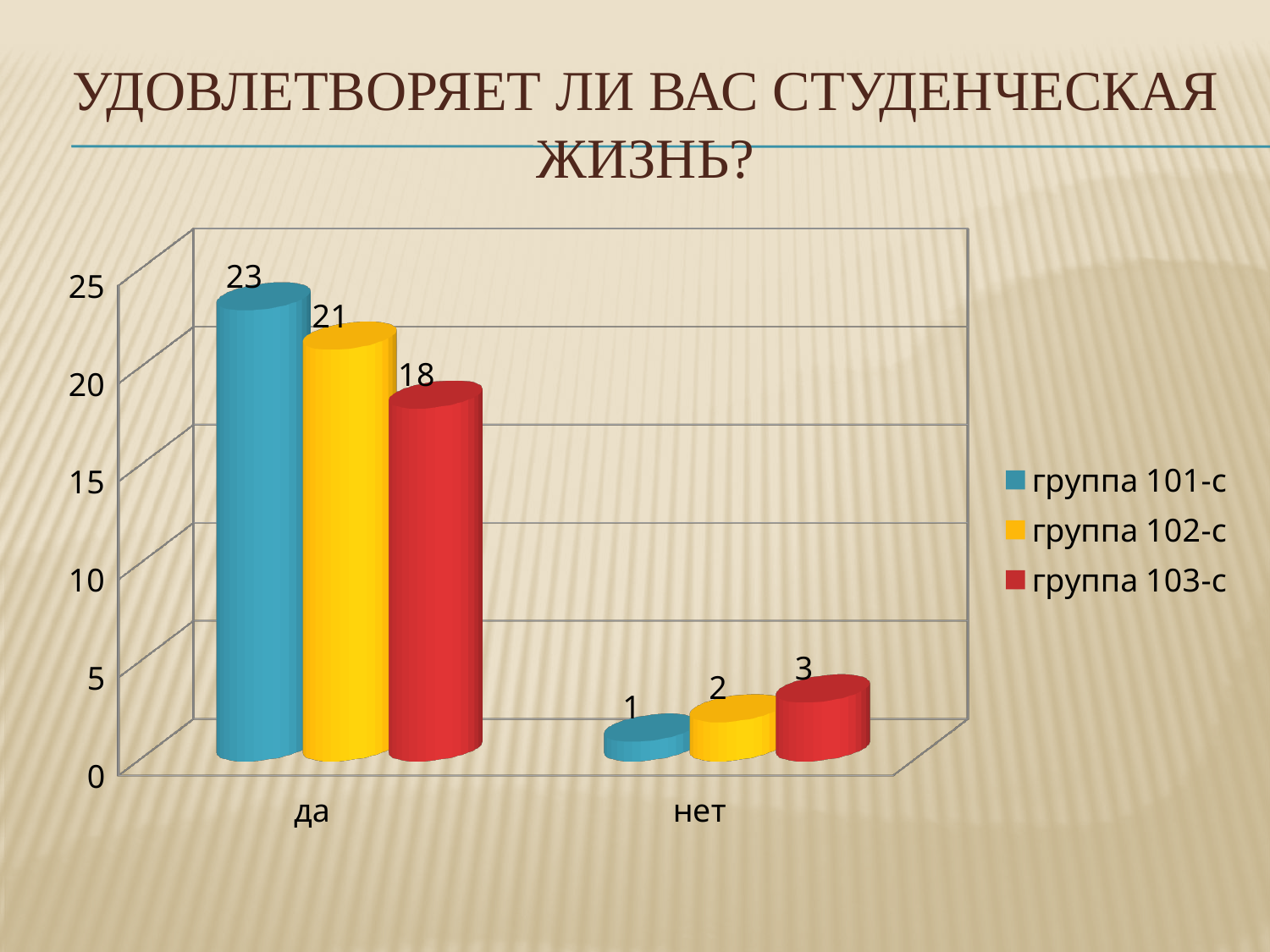
Which group has the lowest value in the нет category? группа 101-с Which group has the highest value in the да category? группа 101-с What is the difference between группа 101-с and группа 103-с in the да category? 5 Which is larger: группа 102-с for да or группа 103-с for да? группа 102-с for да What is the value for группа 103-с in the нет category? 3 What kind of chart is shown on the slide? bar chart What is the value for группа 101-с in the нет category? 1 What is the value for группа 102-с in the да category? 21 What is the value for группа 101-с in the да category? 23 What colour represents группа 102-с in the chart? yellow How many series does the legend list? 3 How many categories are shown on the x axis? 2